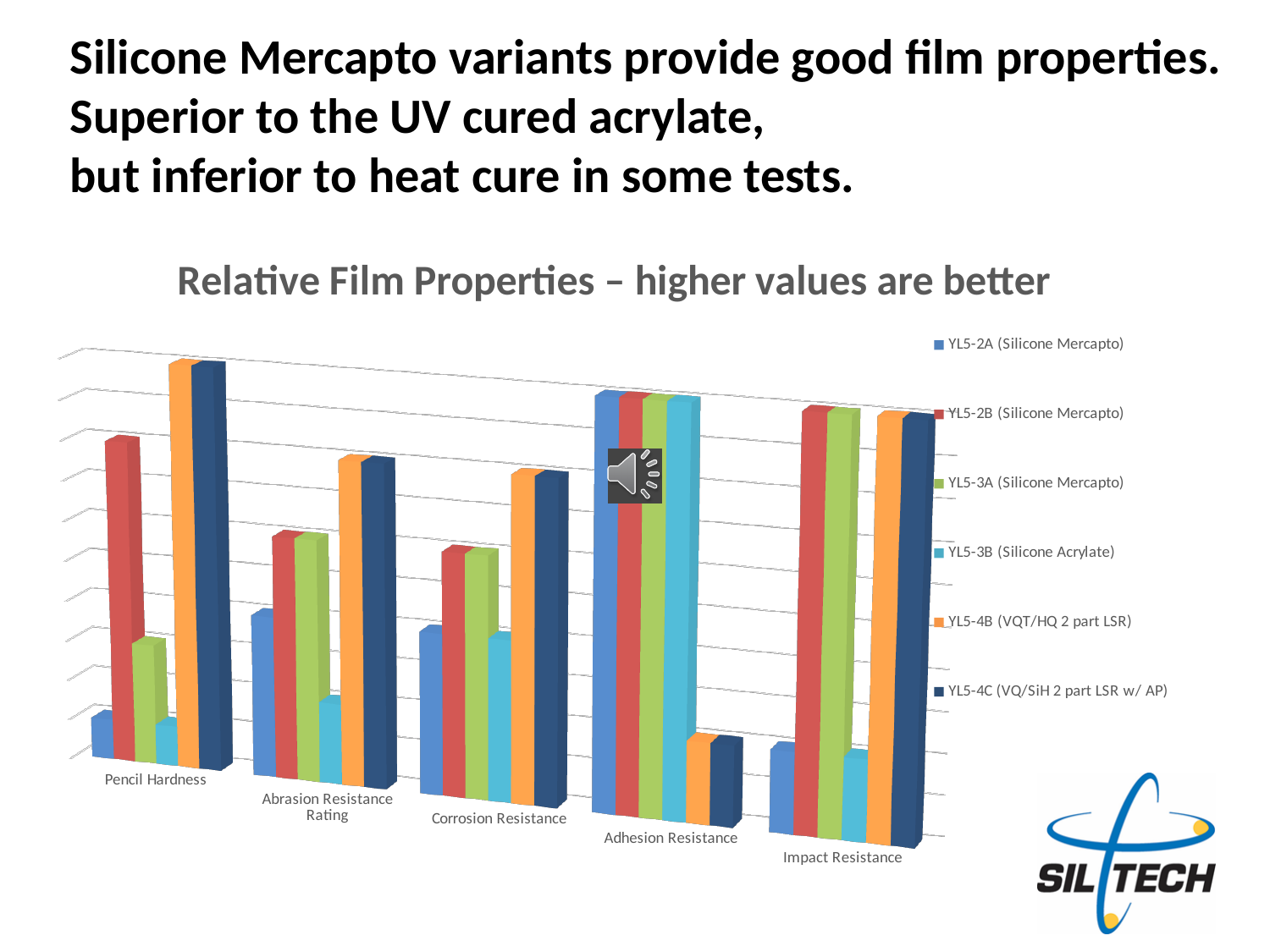
In which category does YL5-4B (VQT/HQ 2 part LSR) have its lowest value? Adhesion Resistance Which series in the legend is labelled as a Silicone Acrylate? YL5-3B (Silicone Acrylate) In which category does YL5-3B (Silicone Acrylate) have its highest value? Adhesion Resistance For Pencil Hardness, which is larger: YL5-2B (Silicone Mercapto) or YL5-3A (Silicone Mercapto)? YL5-2B (Silicone Mercapto) Which series has the lowest value for Abrasion Resistance Rating? YL5-3B (Silicone Acrylate) How many series does the chart legend list? 6 What is the title of the chart? Relative Film Properties – higher values are better What kind of chart is shown on the slide? bar chart For Adhesion Resistance, which is larger: YL5-3B (Silicone Acrylate) or YL5-4B (VQT/HQ 2 part LSR)? YL5-3B (Silicone Acrylate) For Corrosion Resistance, which is larger: YL5-2B (Silicone Mercapto) or YL5-2A (Silicone Mercapto)? YL5-2B (Silicone Mercapto) How many categories are shown on the x axis of the chart? 5